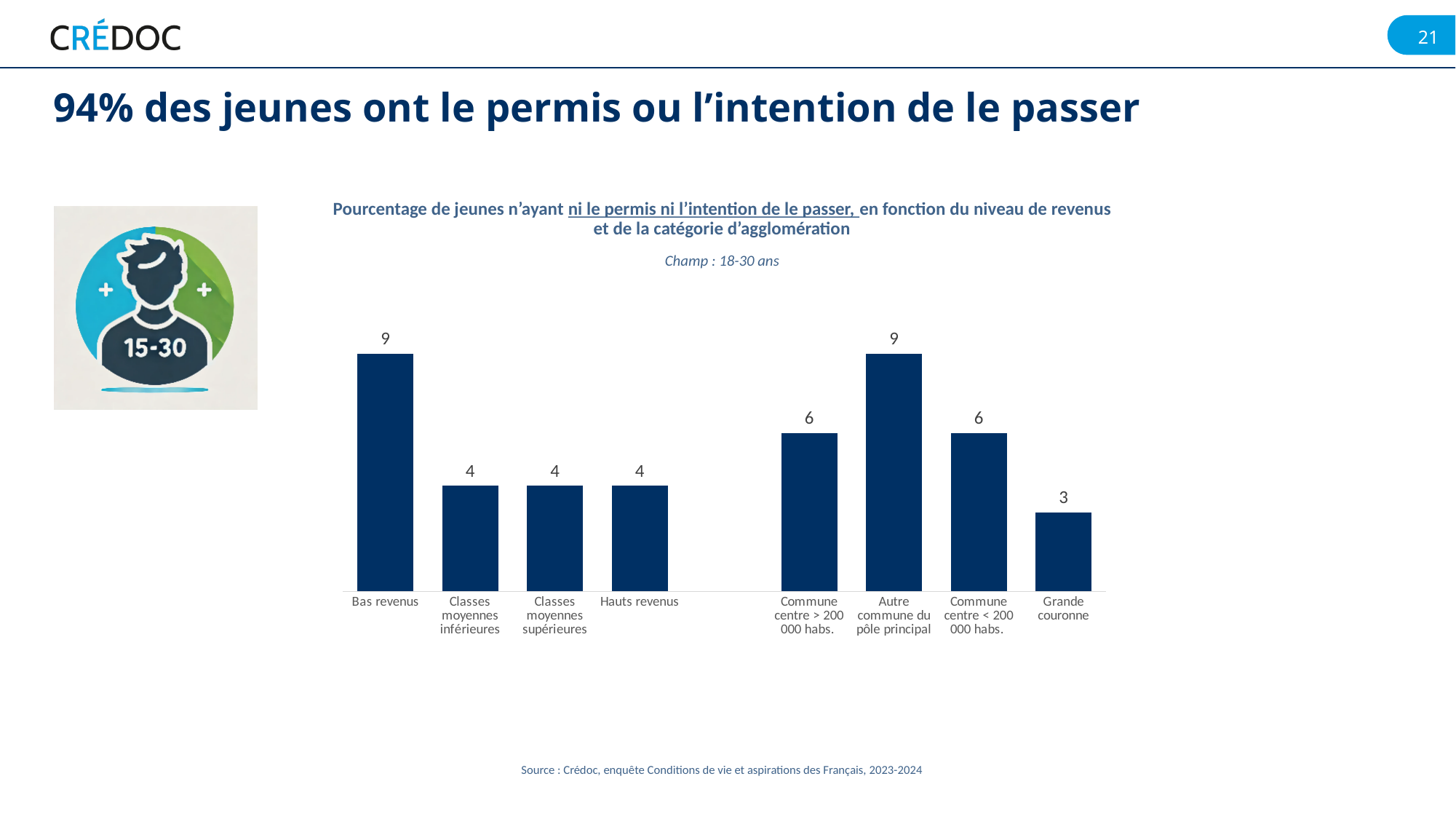
What is the difference between the values for Commune centre > 200 000 habs. and Grande couronne? 3 What is the value for Autre commune du pôle principal? 9 Which category has the lowest value? Grande couronne What is the value for Bas revenus? 9 What is the difference between the values for Bas revenus and Hauts revenus? 5 What is the population scope (Champ) stated under the chart title? 18-30 ans What is the value for Grande couronne? 3 How many bars are shown in the chart? 8 What is the value for Hauts revenus? 4 What colour are the bars in the chart? Dark blue What kind of chart is shown on the slide? Bar chart Which is larger, the value for Commune centre < 200 000 habs. or the value for Classes moyennes supérieures? Commune centre < 200 000 habs.